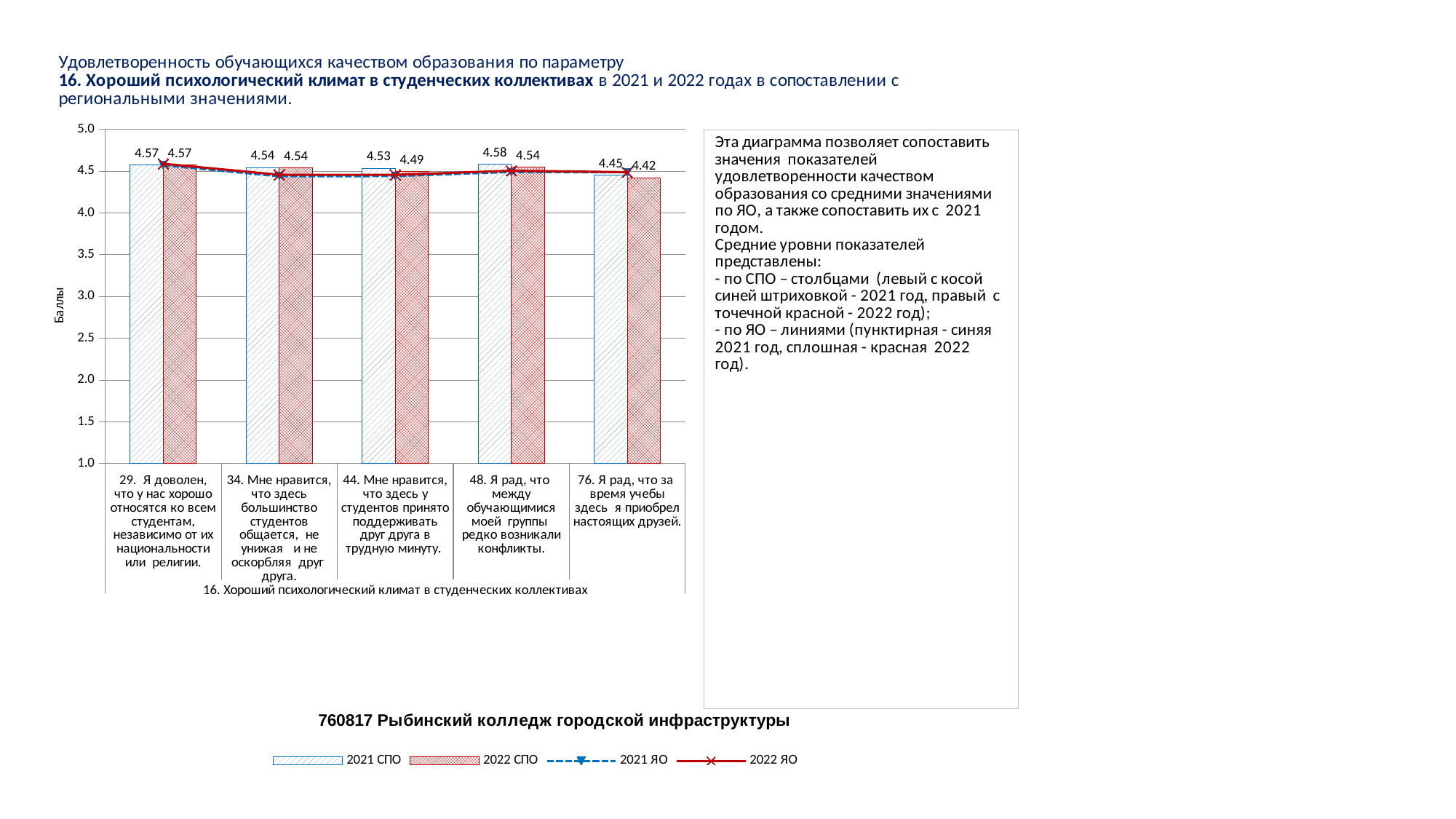
What is the 2022 СПО value for item 44 (Мне нравится, что здесь у студентов принято поддерживать друг друга)? 4.49 Which item has the lowest 2022 СПО value? 76. Я рад, что за время учебы здесь я приобрел настоящих друзей. For item 44, which is larger: the 2021 СПО value or the 2022 СПО value? 2021 СПО Which item has the highest 2021 СПО value? 48. Я рад, что между обучающимися моей группы редко возникали конфликты. How many items (categories) are shown on the x axis? 5 What is the difference between the 2021 СПО and 2022 СПО values for item 76? 0.03 What is the title of the vertical axis? Баллы What is the difference between the 2021 СПО and 2022 СПО values for item 48? 0.04 How many series does the legend list? 4 What is the 2022 СПО value for item 76 (Я рад, что за время учебы здесь я приобрел настоящих друзей)? 4.42 What is the 2021 СПО value for item 29 (Я доволен, что у нас хорошо относятся ко всем студентам)? 4.57 Is the 2022 СПО value for item 34 greater or less than 4.0? greater